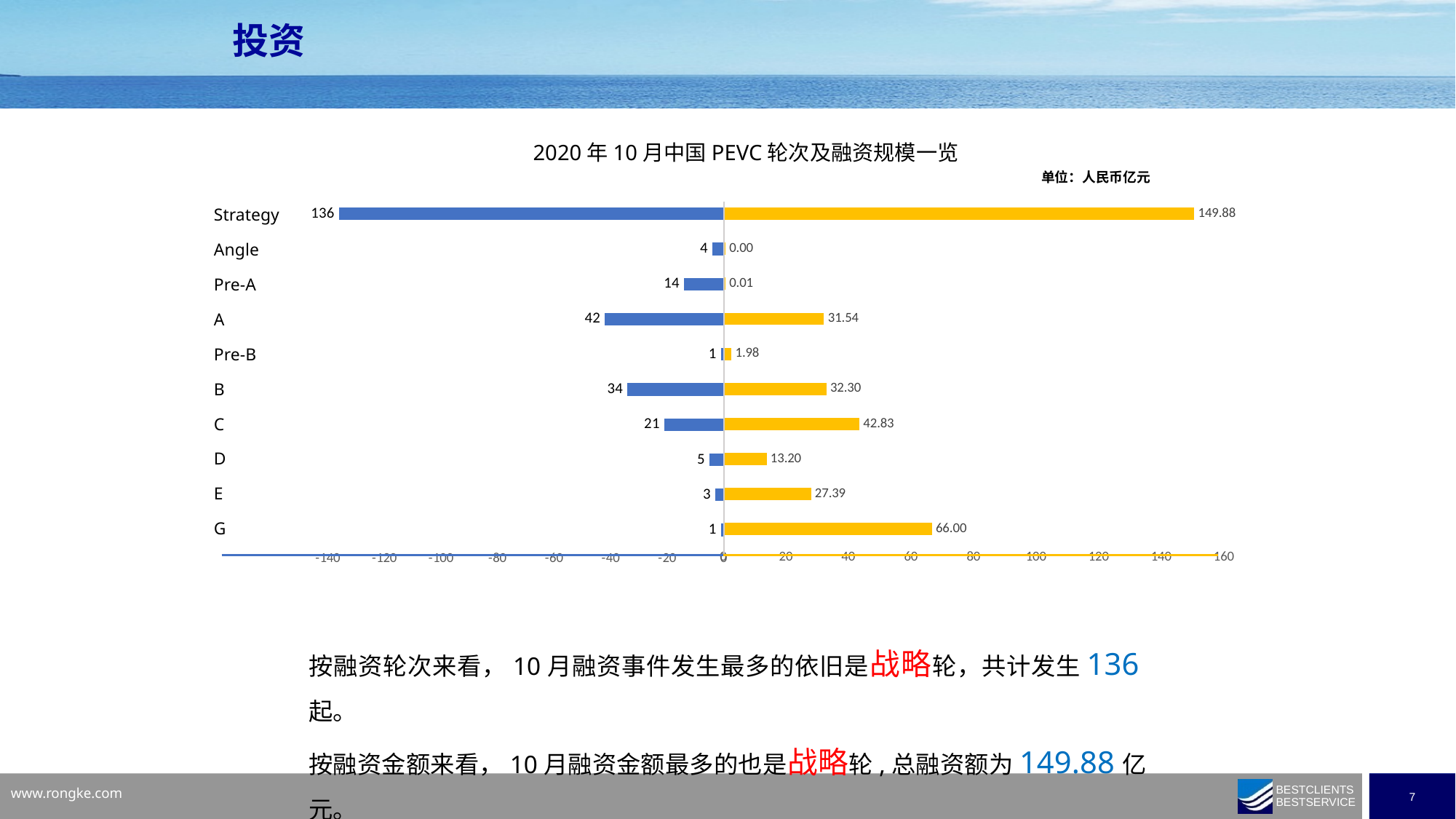
What is the title of the chart? 2020 年 10 月中国 PEVC 轮次及融资规模一览 What is the value of the blue bar for Pre-A? 14 Which category has the largest yellow bar? Strategy What is the difference between the yellow bar values for C and B? 10.53 What is the difference between the blue bar values for Strategy and A? 94 What type of chart is shown on the slide? Bar chart What is the value of the yellow bar for Strategy? 149.88 Which has the larger blue bar value, B or C? B What is the value of the blue bar for A? 42 What is the value of the yellow bar for G? 66.00 How many categories are shown on the chart? 10 Which category has the smallest yellow bar value? Angle